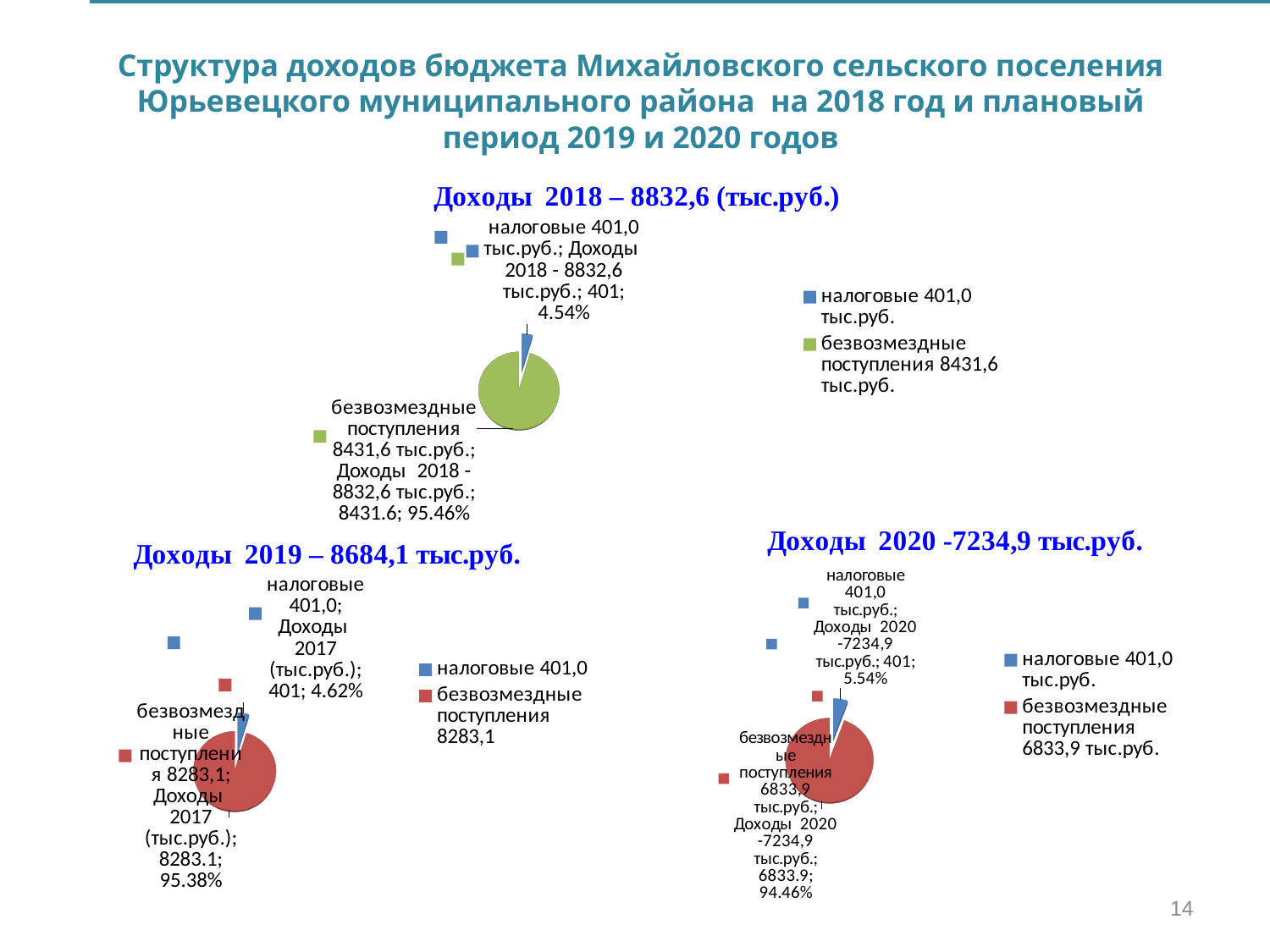
In the "Доходы 2018 – 8832,6 (тыс.руб.)" chart, what share of the pie is "безвозмездные поступления"? 95.46% In the "Доходы 2019 – 8684,1 тыс.руб." chart, what share of the pie is "налоговые"? 4.62% How many slices does the "Доходы 2018 – 8832,6 (тыс.руб.)" pie chart have? 2 What kind of chart is used for "Доходы 2018 – 8832,6 (тыс.руб.)"? pie chart In the "Доходы 2019 – 8684,1 тыс.руб." chart, which slice is the smallest? налоговые In the "Доходы 2019 – 8684,1 тыс.руб." chart, what is the value for "безвозмездные поступления"? 8283.1 In the "Доходы 2020 -7234,9 тыс.руб." chart, what colour is the "безвозмездные поступления" slice? red In the "Доходы 2018 – 8832,6 (тыс.руб.)" chart, what share of the pie is "налоговые"? 4.54% In the "Доходы 2018 – 8832,6 (тыс.руб.)" chart, what is the value for "безвозмездные поступления"? 8431.6 In the "Доходы 2020 -7234,9 тыс.руб." chart, what is the value for "налоговые"? 401 In the "Доходы 2020 -7234,9 тыс.руб." chart, which slice is the largest? безвозмездные поступления